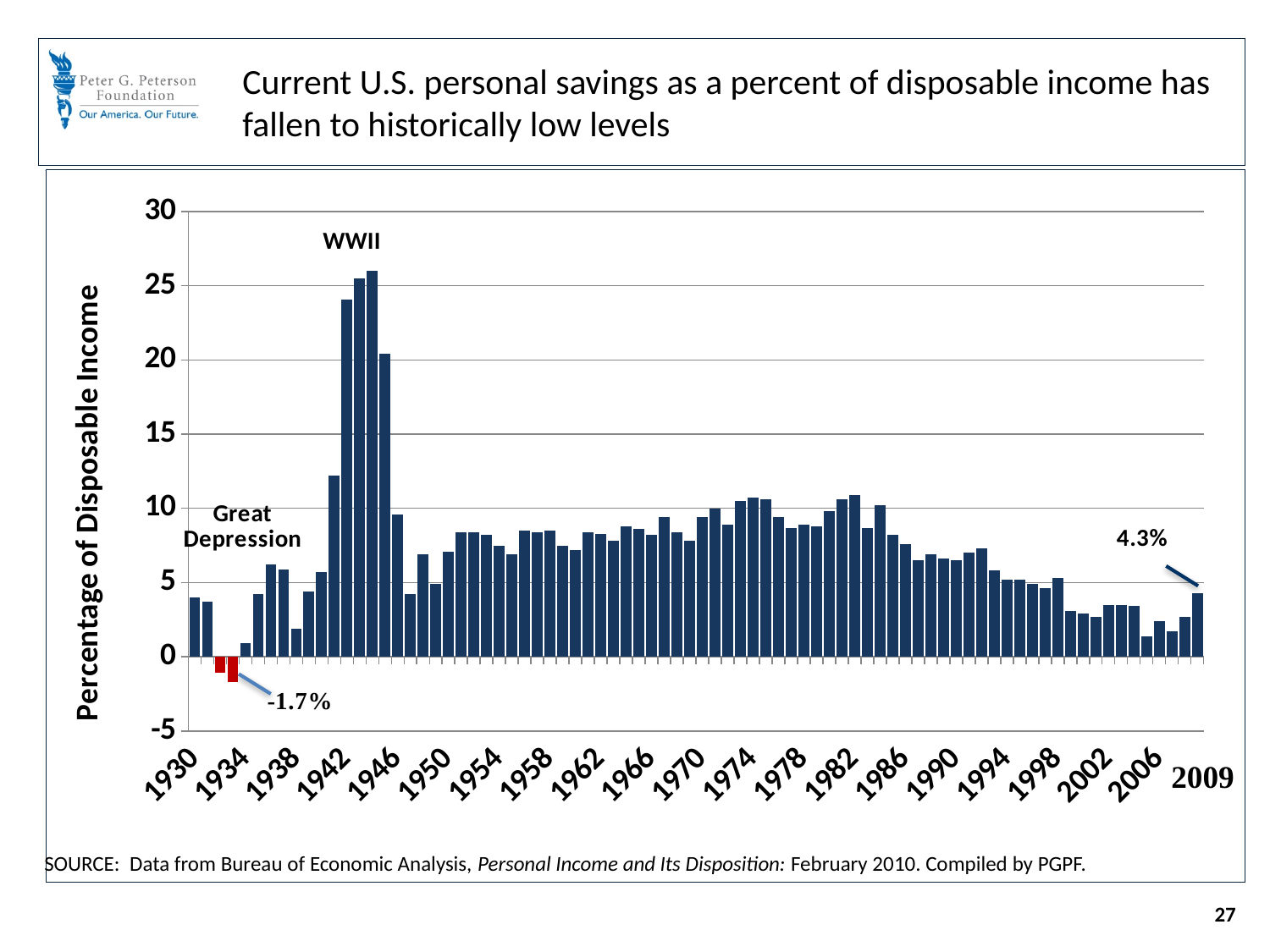
Is the value for 1970 greater or less than 5? greater What is the lowest value labeled on the chart, during the Great Depression? -1.7% What kind of chart is shown on the slide? bar chart Which labeled period on the chart contains the highest bars? WWII What is the title of the vertical axis? Percentage of Disposable Income Between 1986 and 2006, do the values generally rise or fall? fall Which is larger, the value for 2009 or the lowest Great Depression value? 2009 Is the value for 2009 greater or less than 5? less Is the value for 1930 greater or less than 5? less What is the difference between the 2009 value (4.3%) and the Great Depression low (-1.7%)? 6 percentage points What is the personal savings rate shown for 2009? 4.3%